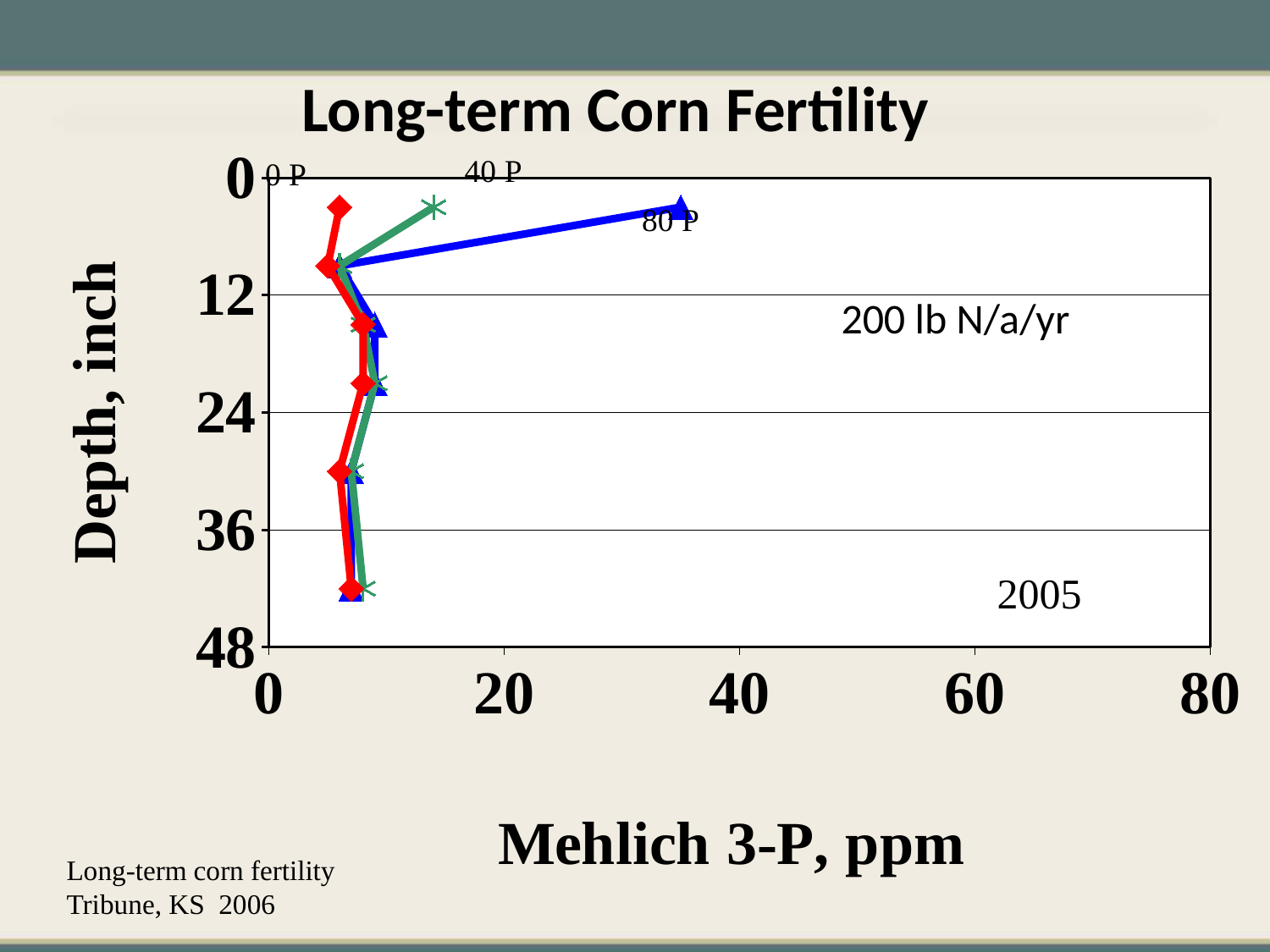
What kind of chart is shown on the slide? line chart Which series has the lowest Mehlich 3-P value at the shallowest depth? 0 P At the shallowest depth, which series has the larger Mehlich 3-P value, 40 P or 80 P? 80 P What is the label of the horizontal axis? Mehlich 3-P, ppm Is the Mehlich 3-P value for the 0 P series at the shallowest depth greater or less than 20? less How many series are plotted on the chart? 3 Does the Mehlich 3-P value for the 80 P series rise or fall as depth increases from the shallowest to the deepest sample? fall Is the Mehlich 3-P value for the 80 P series at the shallowest depth greater or less than 20? greater Is the Mehlich 3-P value for the 40 P series at the shallowest depth greater or less than 20? less Which series has the highest Mehlich 3-P value at the shallowest depth? 80 P What is the title of the chart? Long-term Corn Fertility